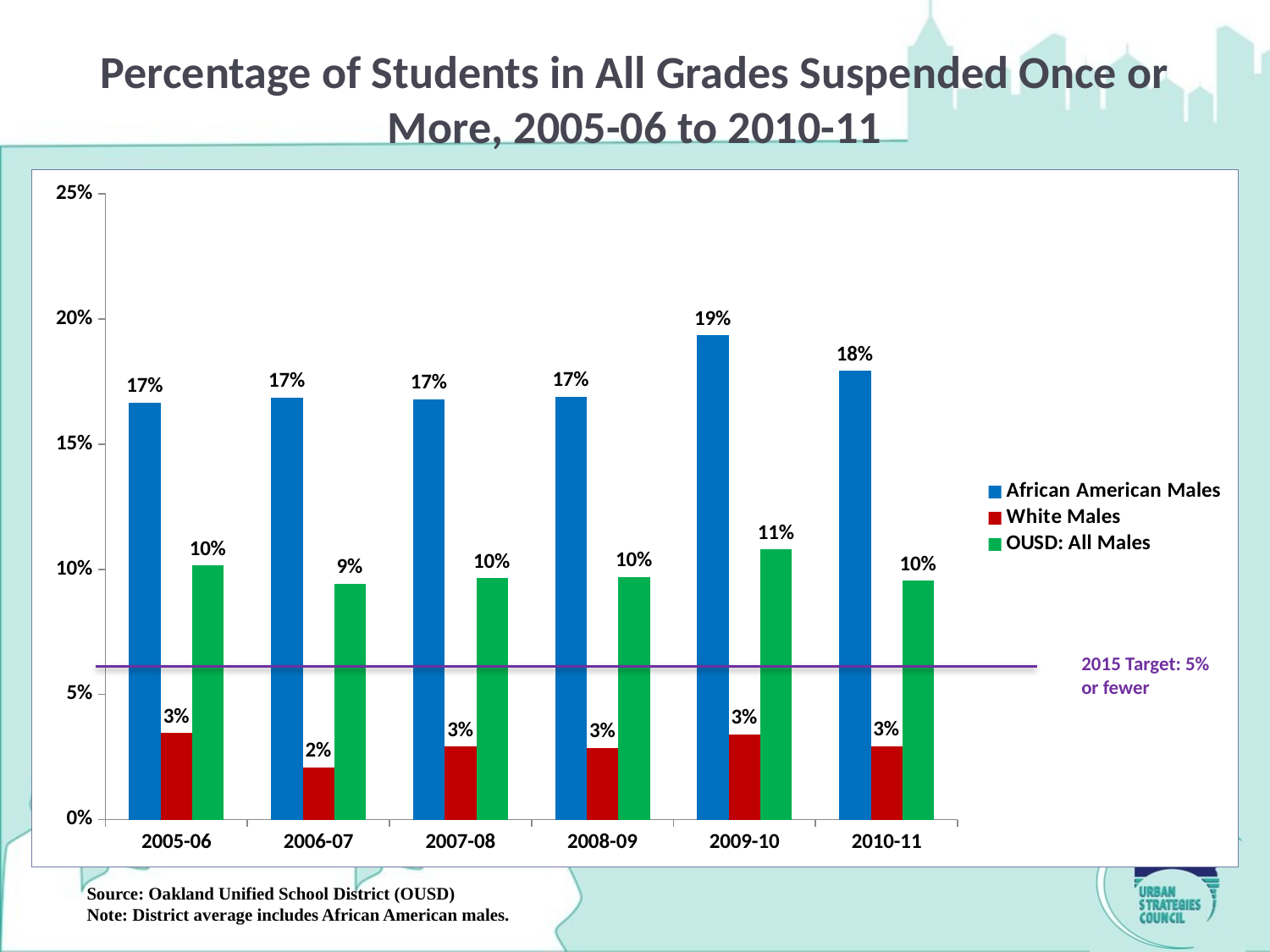
What is the value for OUSD: All Males in 2009-10? 11% What is the 2015 target shown by the horizontal line on the chart? 5% or fewer How many school years are shown on the x axis? 6 Which is larger in 2008-09: the OUSD: All Males value or the White Males value? OUSD: All Males In which year was the White Males value lowest? 2006-07 Is the value for African American Males in 2009-10 greater or less than 15%? greater How many series does the legend list? 3 What is the difference between the African American Males value and the White Males value in 2010-11? 15% What is the value for White Males in 2006-07? 2% What kind of chart is shown on the slide? bar chart In which year was the African American Males value highest? 2009-10 What percentage of African American Males were suspended once or more in 2009-10? 19%